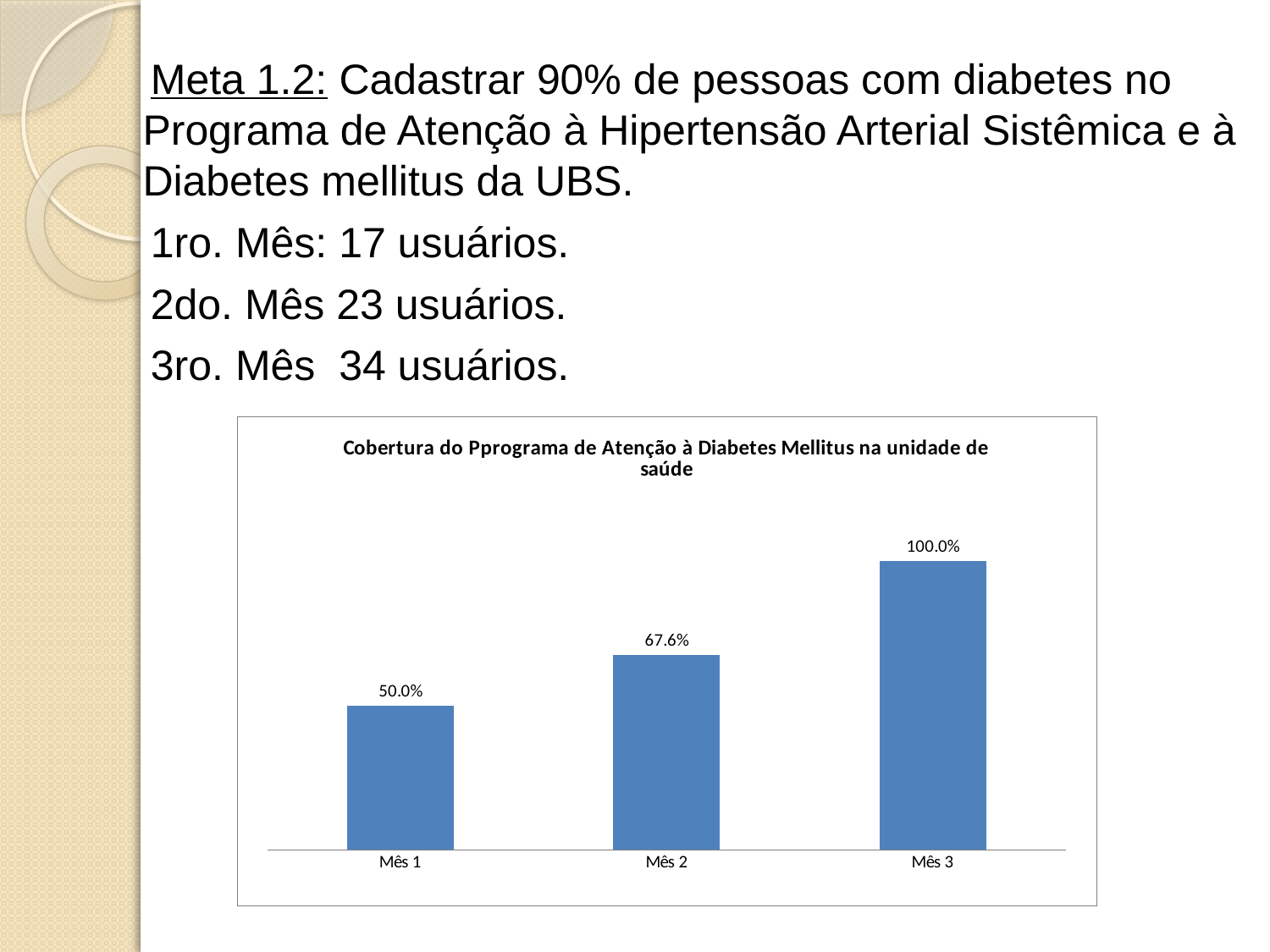
What is the value for Mês 2? 67.6% What is the value for Mês 3? 100.0% Which month has the lowest value? Mês 1 What is the difference between the values for Mês 2 and Mês 1? 17.6% What is the value for Mês 1? 50.0% What is the difference between the values for Mês 3 and Mês 1? 50.0% Do the values rise or fall from Mês 1 to Mês 3? Rise What kind of chart is shown on the slide? Bar chart Which month has the highest value? Mês 3 Which is larger, the value for Mês 2 or the value for Mês 3? Mês 3 How many months are shown on the chart? 3 What is the title of the chart? Cobertura do Pprograma de Atenção à Diabetes Mellitus na unidade de saúde